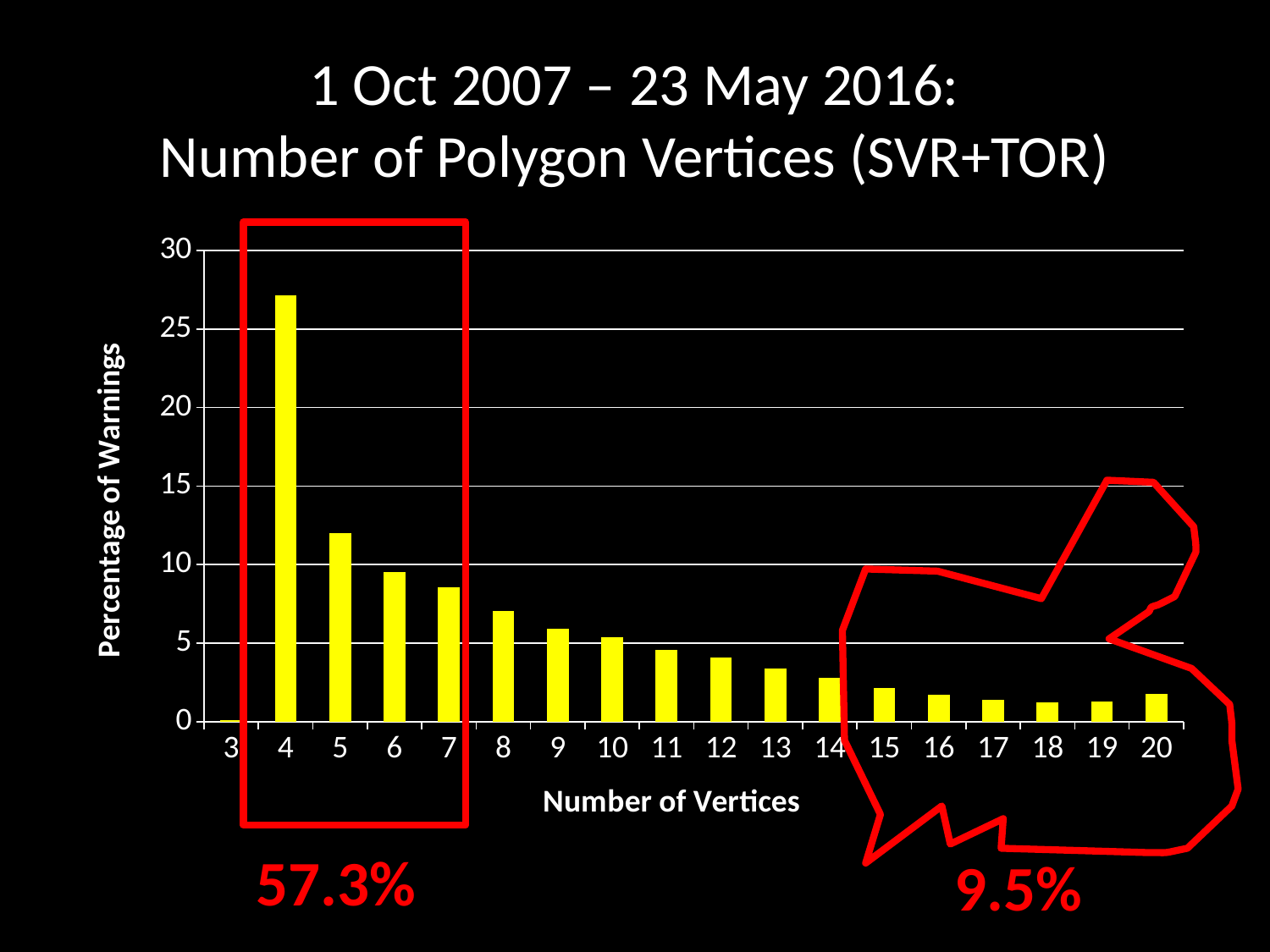
Which has a higher percentage of warnings, 5 vertices or 6 vertices? 5 vertices Which number of vertices has the highest percentage of warnings? 4 Is the percentage of warnings for 5 vertices greater or less than 10? greater What kind of chart is shown on the slide? bar chart Do the percentages generally rise or fall as the number of vertices increases from 4 to 20? fall Which number of vertices has the lowest percentage of warnings? 3 What percentage is written below the red outline around 15 to 20 vertices? 9.5% Is the percentage of warnings for 8 vertices greater or less than 5? greater What percentage is written below the red box around 4 to 7 vertices? 57.3% Is the percentage of warnings for 4 vertices greater or less than 25? greater How many vertex categories are plotted along the x axis? 18